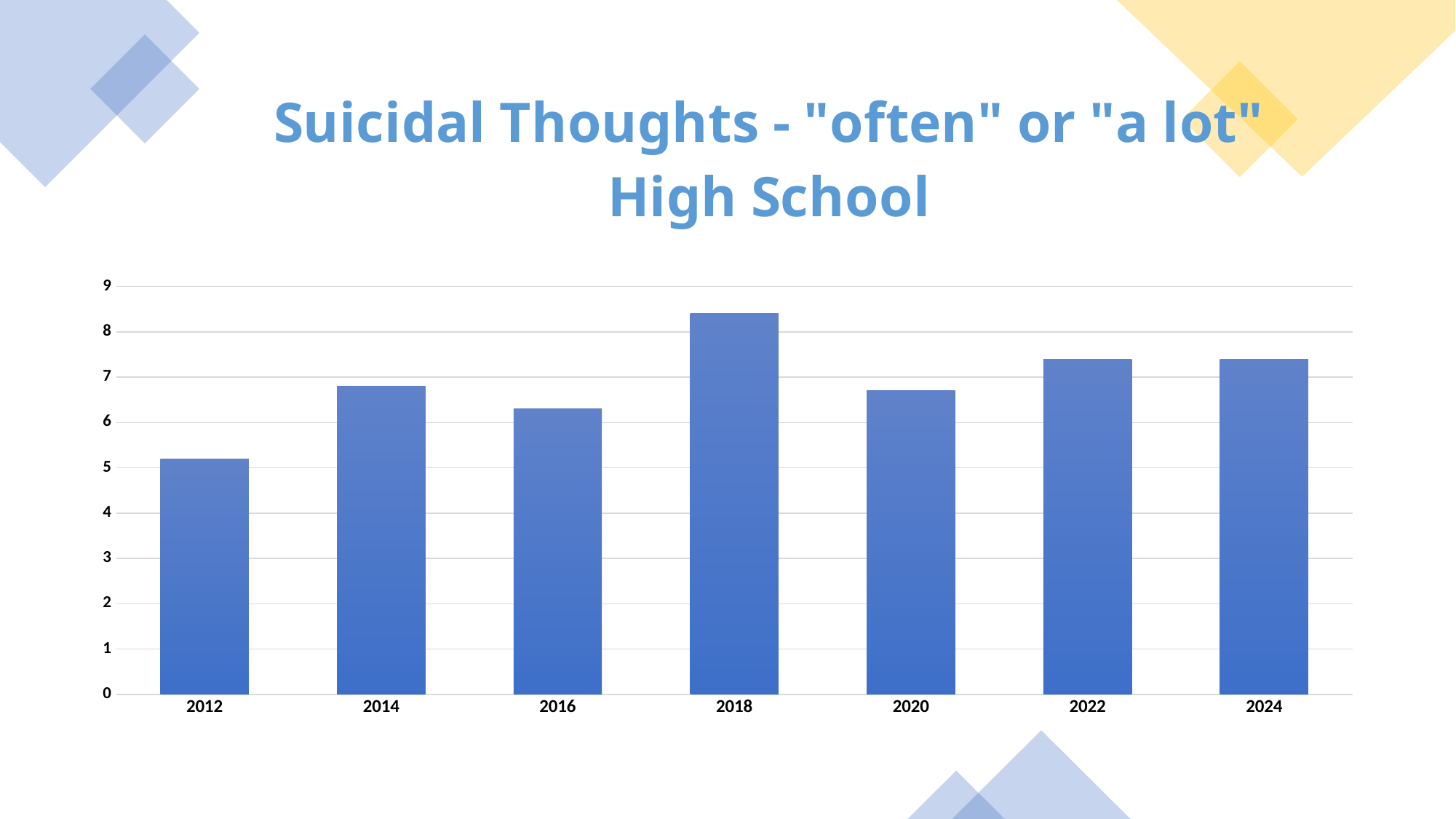
Is the value for 2018 greater or less than 8? greater Which is larger, the value for 2022 or the value for 2016? 2022 What kind of chart is shown on the slide? bar chart Which year has the lowest bar? 2012 Which is larger, the value for 2018 or the value for 2020? 2018 Is the value for 2022 greater or less than 7? greater Is the value for 2016 greater or less than 7? less Which year has the highest bar? 2018 What is the title of the chart? Suicidal Thoughts - "often" or "a lot" High School How many years are shown on the x axis of the chart? 7